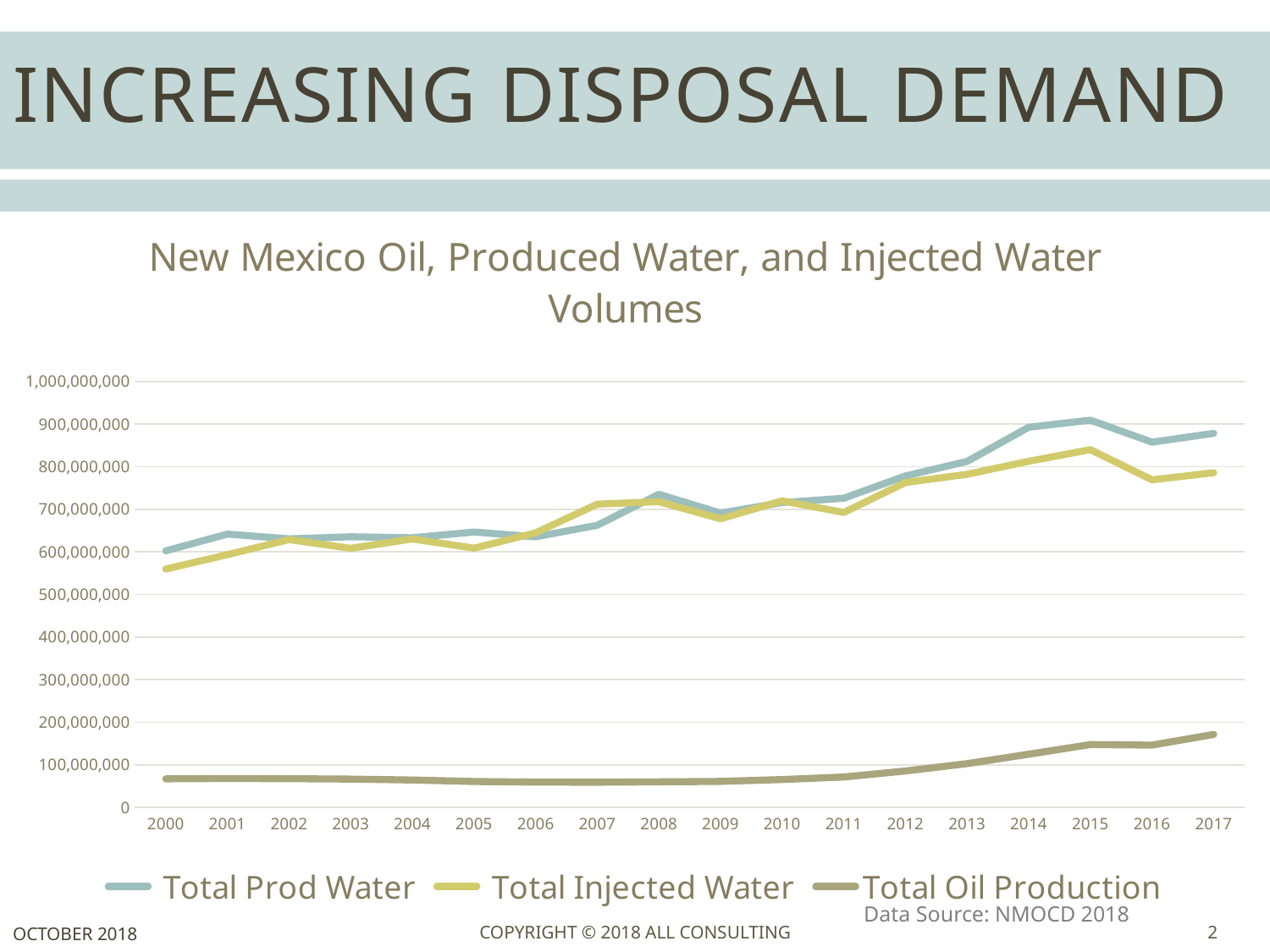
In which year is Total Oil Production highest? 2017 How many series does the chart legend list? 3 Does Total Oil Production generally rise or fall from 2000 to 2017? Rise How many years are plotted along the x axis of the chart? 18 Is the value for Total Oil Production in 2017 greater or less than 200,000,000? less In which year is Total Injected Water highest? 2015 Is the value for Total Prod Water in 2017 greater or less than 800,000,000? greater What is the title of the chart? New Mexico Oil, Produced Water, and Injected Water Volumes What kind of chart is shown on the slide? Line chart In which year is Total Injected Water lowest? 2000 Which series is drawn with the yellow line in the chart? Total Injected Water In 2017, which is larger: Total Prod Water or Total Injected Water? Total Prod Water